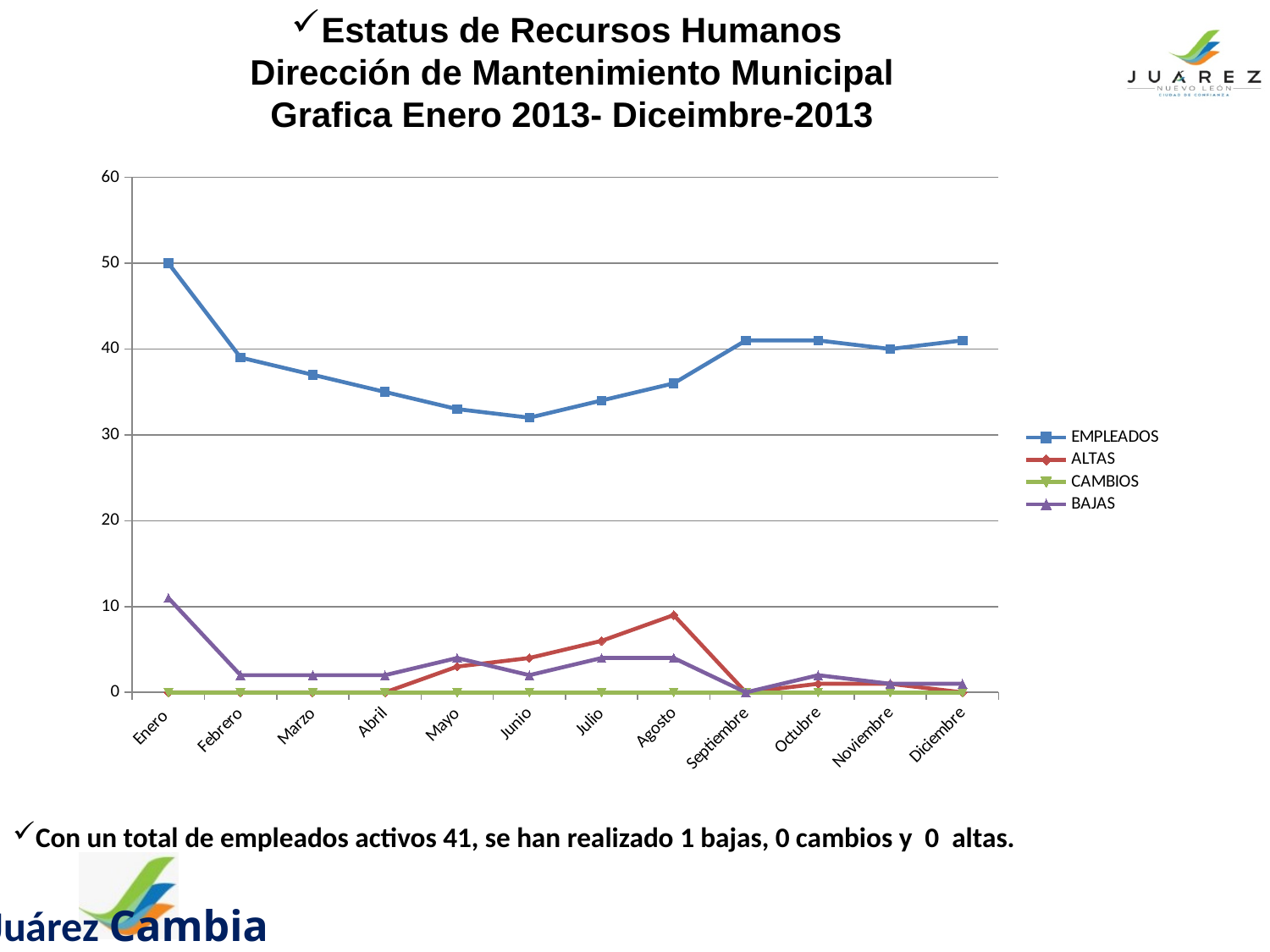
What is the value of EMPLEADOS in Enero? 50 In which month is the EMPLEADOS series lowest? Junio How many months are plotted along the x axis? 12 Does the EMPLEADOS series rise or fall from Enero to Junio? fall In which month is the BAJAS series highest? Enero In which month is the EMPLEADOS series highest? Enero Is the value for EMPLEADOS in Junio greater or less than 40? less How many series does the legend list? 4 What is the value of CAMBIOS in Mayo? 0 In Agosto, which is larger: ALTAS or BAJAS? ALTAS Is the value for EMPLEADOS in Septiembre greater or less than 40? greater What kind of chart is shown on the slide? Line chart